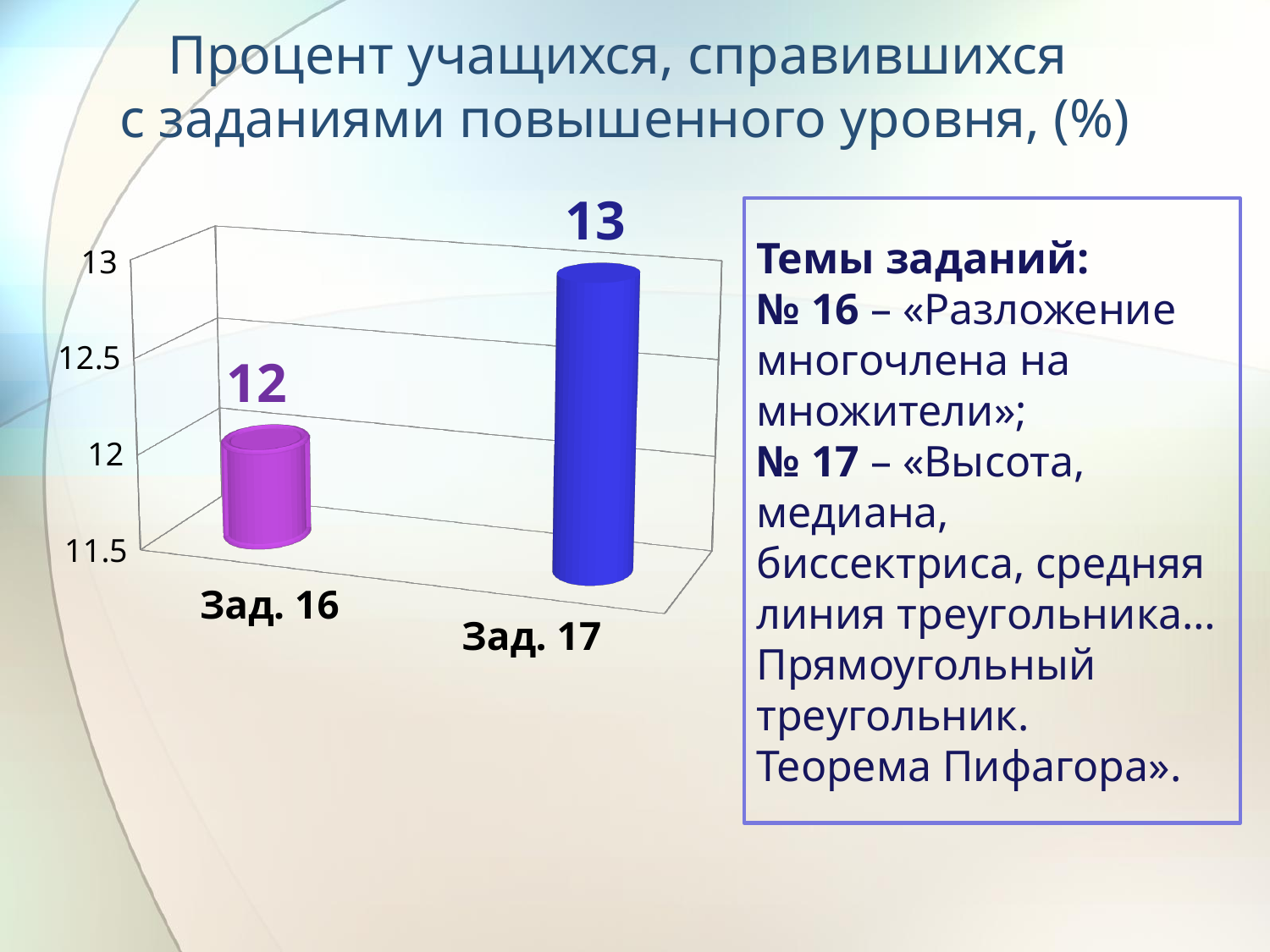
Do the values rise or fall from Зад. 16 to Зад. 17? rise How many categories are shown in the chart? 2 Is the value for Зад. 17 greater or less than 12.5? greater Which category has the highest value? Зад. 17 What is the value for Зад. 17? 13 Which is larger, the value for Зад. 16 or Зад. 17? Зад. 17 What is the difference between the values for Зад. 17 and Зад. 16? 1 What kind of chart is shown on the slide? bar chart What colour is the bar for Зад. 17? blue Which category has the lowest value? Зад. 16 What is the value for Зад. 16? 12 Is the value for Зад. 16 greater or less than 12.5? less